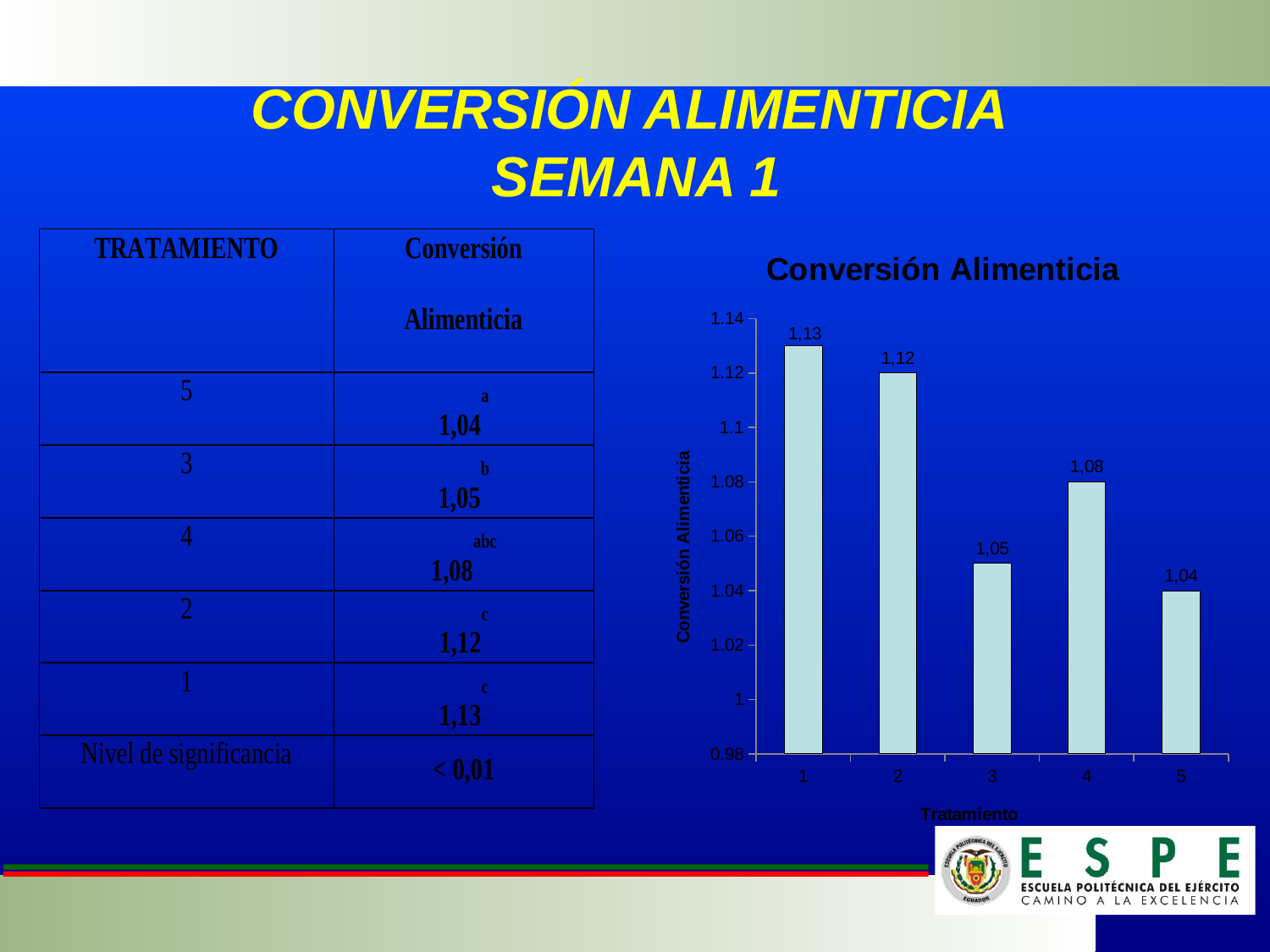
How many Tratamiento categories are plotted in the chart? 5 Is the value for Tratamiento 2 greater or less than 1.1? greater What is the difference between the values for Tratamiento 1 and Tratamiento 5 in the chart? 0,09 What is the label of the x axis of the chart? Tratamiento What is the value for Tratamiento 5 in the Conversión Alimenticia chart? 1,04 What is the difference between the values for Tratamiento 2 and Tratamiento 3 in the chart? 0,07 Which Tratamiento has the lowest Conversión Alimenticia in the chart? 5 What is the value for Tratamiento 1 in the Conversión Alimenticia chart? 1,13 What kind of chart is shown on the slide? bar chart What is the value for Tratamiento 4 in the Conversión Alimenticia chart? 1,08 Which Tratamiento has the highest Conversión Alimenticia in the chart? 1 Which has a larger value in the chart, Tratamiento 3 or Tratamiento 4? Tratamiento 4